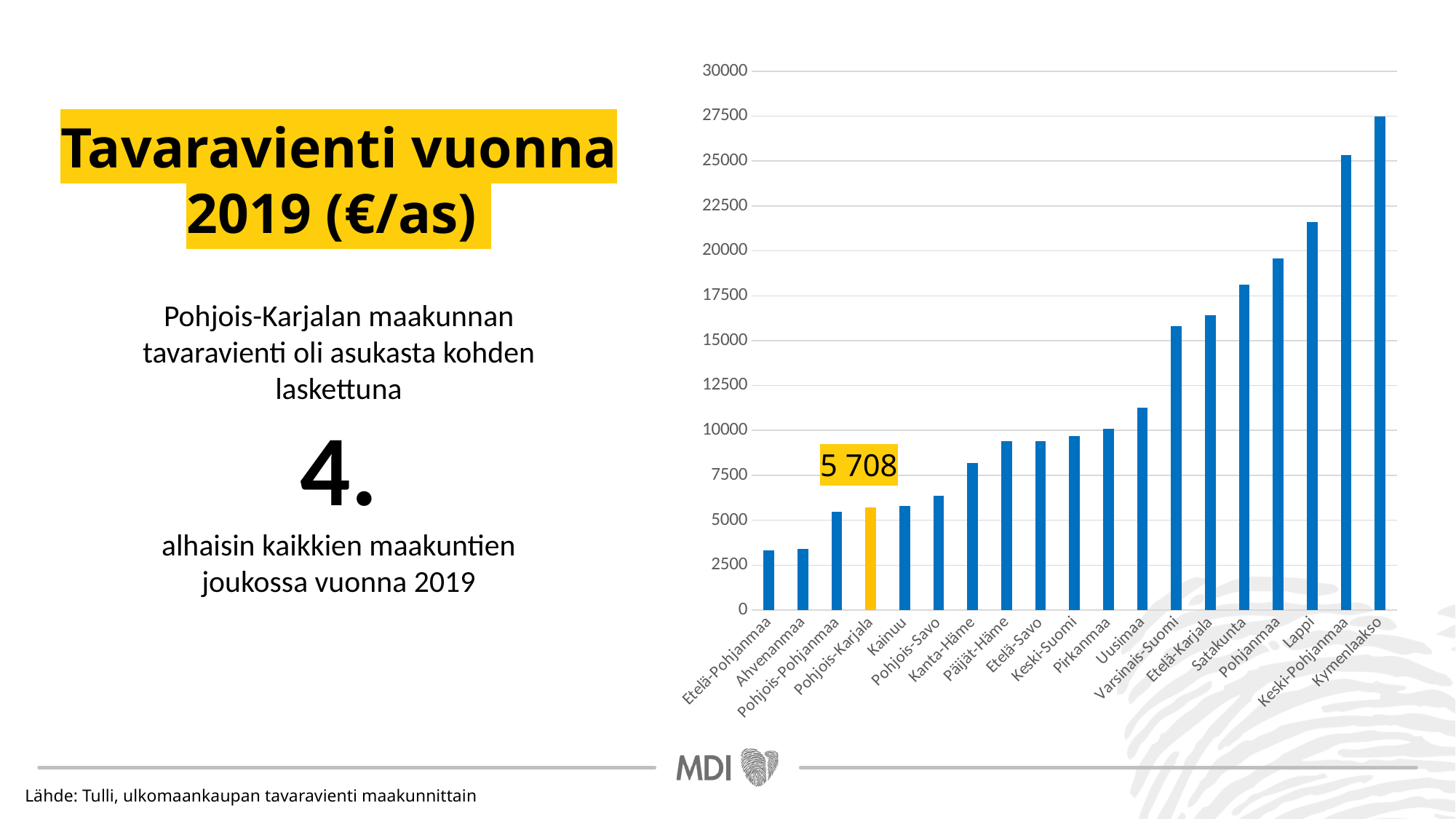
Is the value for Lappi greater or less than 20000? greater Is the value for Etelä-Pohjanmaa greater or less than 5000? less Which region's bar is highlighted in yellow in the chart? Pohjois-Karjala Do the bar values rise or fall from left to right along the x axis? Rise Is the value for Kymenlaakso greater or less than 25000? greater How many regions (bars) are shown in the chart? 19 Which has a higher value, Kymenlaakso or Lappi? Kymenlaakso What is the value for Pohjois-Karjala in the chart? 5 708 Which region has the highest value in the chart? Kymenlaakso What type of chart is shown on the slide? Bar chart